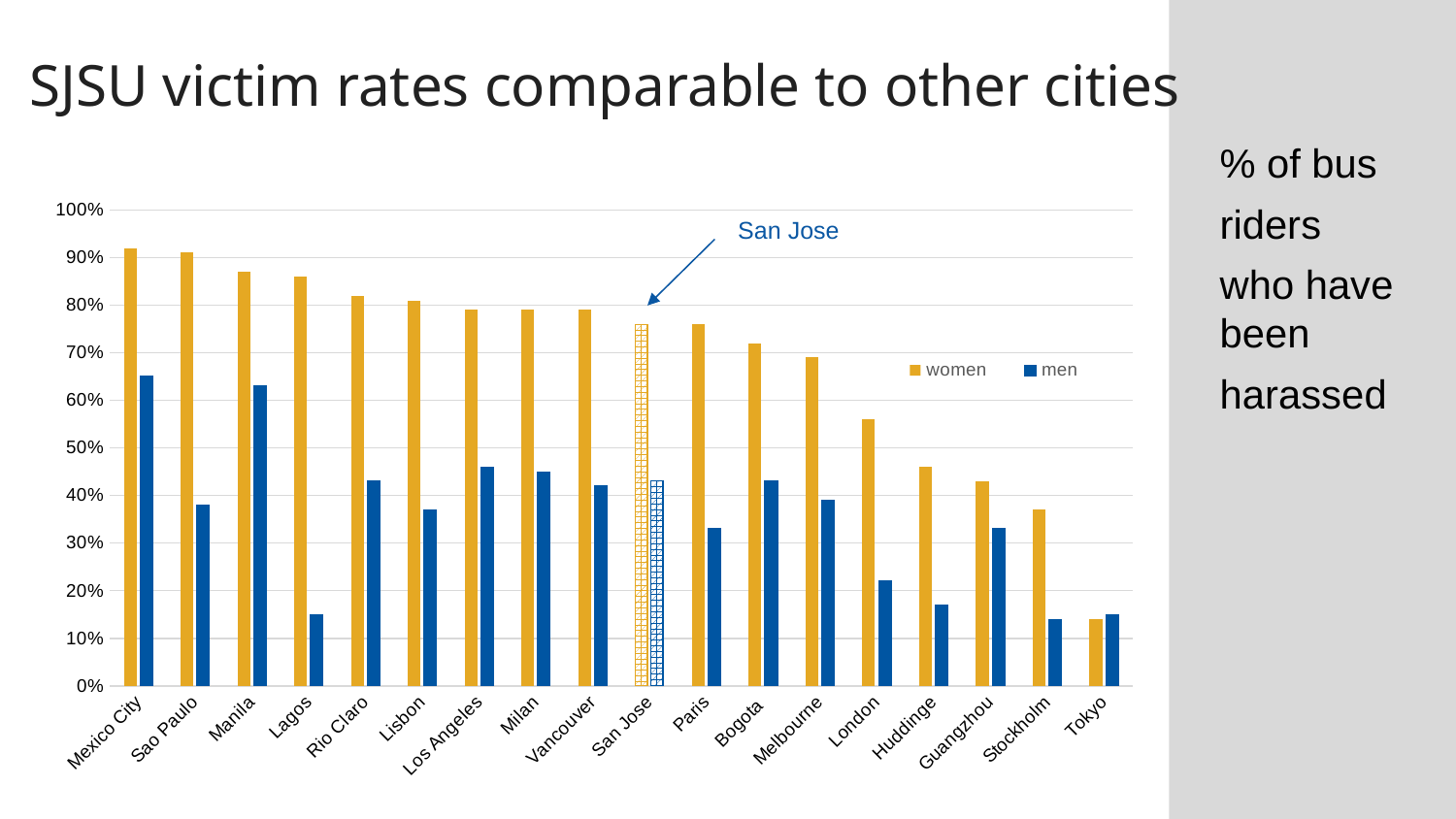
Do the values for women generally rise or fall from left to right along the x axis? fall Which city has the lowest value for women? Tokyo Is the value for men in Paris greater or less than 40%? less Which city is pointed out with an arrow and a label on the chart? San Jose Is the value for women in San Jose greater or less than 70%? greater Is the value for women in London greater or less than 50%? greater How many cities are shown on the x axis of the chart? 18 Which is larger in Lagos, the value for women or the value for men? women How many series does the chart's legend list? 2 What kind of chart is shown on the slide? bar chart Which city has the larger value for men, Los Angeles or Lisbon? Los Angeles